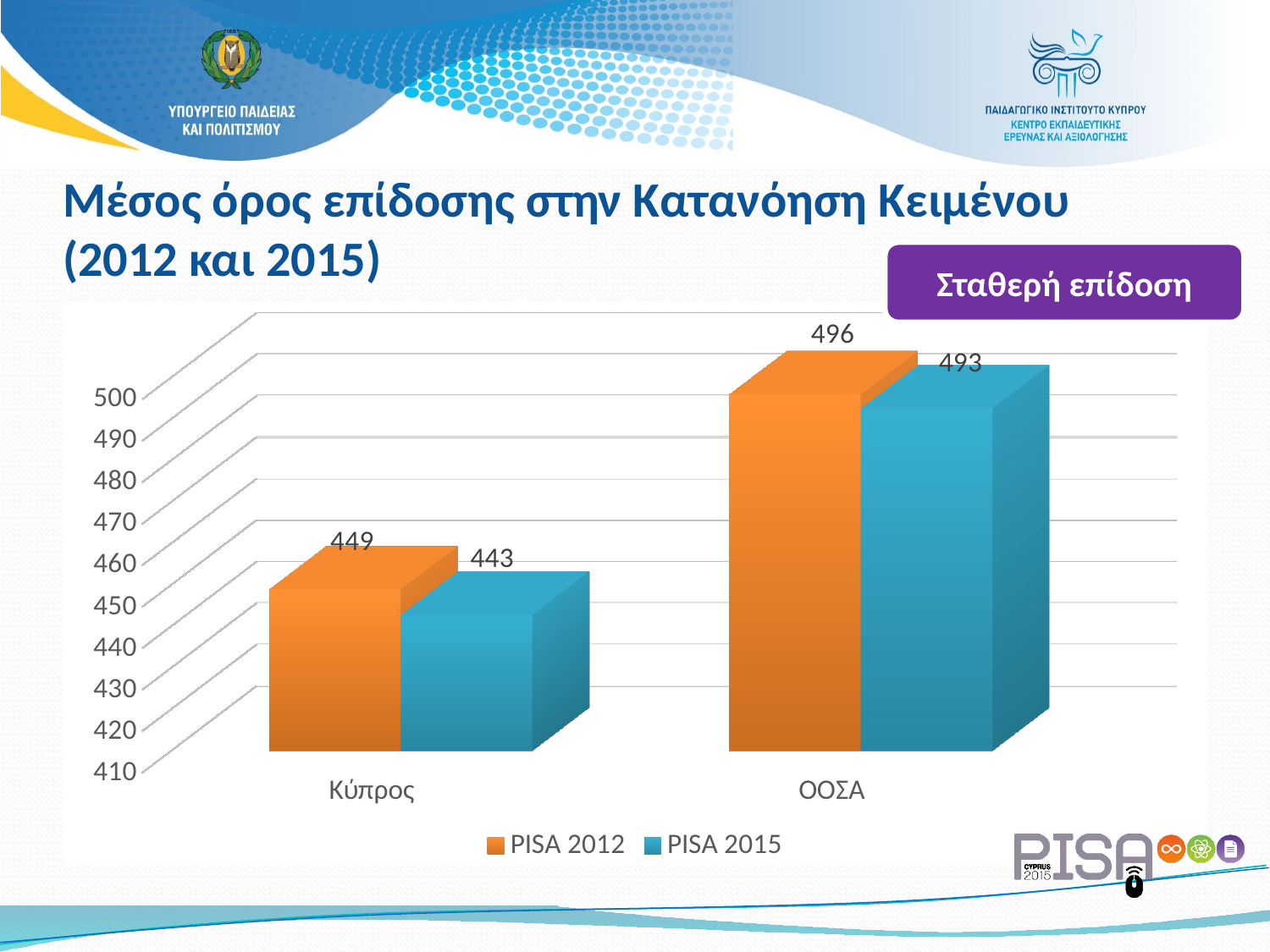
What is the difference between the PISA 2012 values for ΟΟΣΑ and Κύπρος? 47 What is the PISA 2015 value for Κύπρος? 443 What is the difference between the PISA 2012 and PISA 2015 values for Κύπρος? 6 What is the PISA 2015 value for ΟΟΣΑ? 493 What is the PISA 2012 value for Κύπρος? 449 What is the PISA 2012 value for ΟΟΣΑ? 496 Which category has the lowest PISA 2015 value? Κύπρος Which category has the highest PISA 2012 value? ΟΟΣΑ How many categories are shown on the x axis? 2 What kind of chart is shown on the slide? Bar chart Which is larger: the PISA 2015 value for Κύπρος or the PISA 2015 value for ΟΟΣΑ? ΟΟΣΑ How many series does the legend list? 2